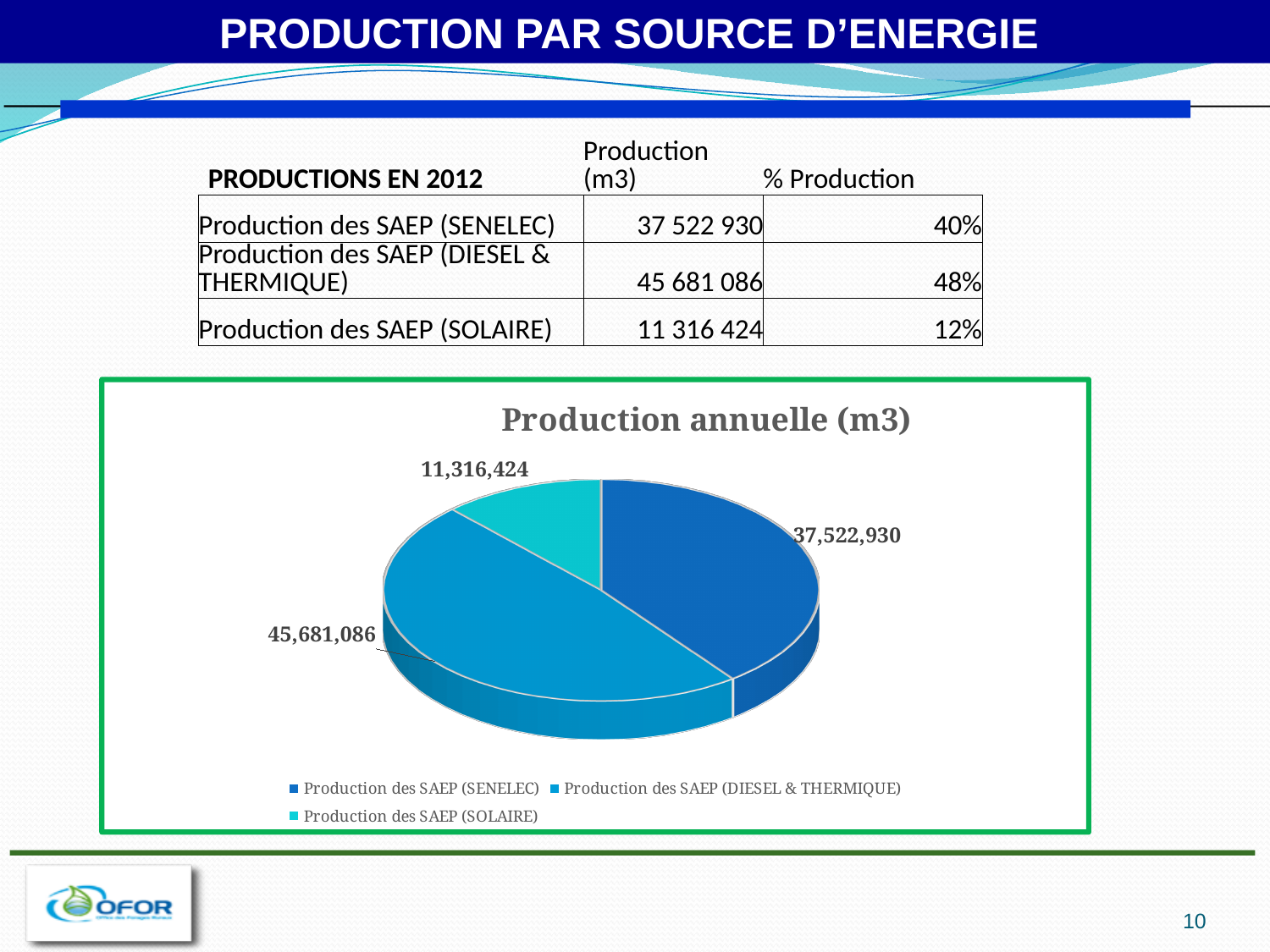
In the pie chart, what is the value for Production des SAEP (SENELEC)? 37,522,930 In the pie chart, what is the value for Production des SAEP (SOLAIRE)? 11,316,424 How many entries does the legend of the pie chart list? 3 What share of the pie does Production des SAEP (SOLAIRE) represent? 12% In the pie chart, what is the value for Production des SAEP (DIESEL & THERMIQUE)? 45,681,086 Which category has the smallest slice in the pie chart? Production des SAEP (SOLAIRE) What kind of chart is shown under the title "Production annuelle (m3)"? pie chart How many slices does the pie chart have? 3 What is the title of the pie chart? Production annuelle (m3) Which category has the largest slice in the pie chart? Production des SAEP (DIESEL & THERMIQUE) What is the difference between the DIESEL & THERMIQUE value and the SENELEC value in the pie chart? 8,158,156 Which is larger in the pie chart: Production des SAEP (SENELEC) or Production des SAEP (SOLAIRE)? Production des SAEP (SENELEC)